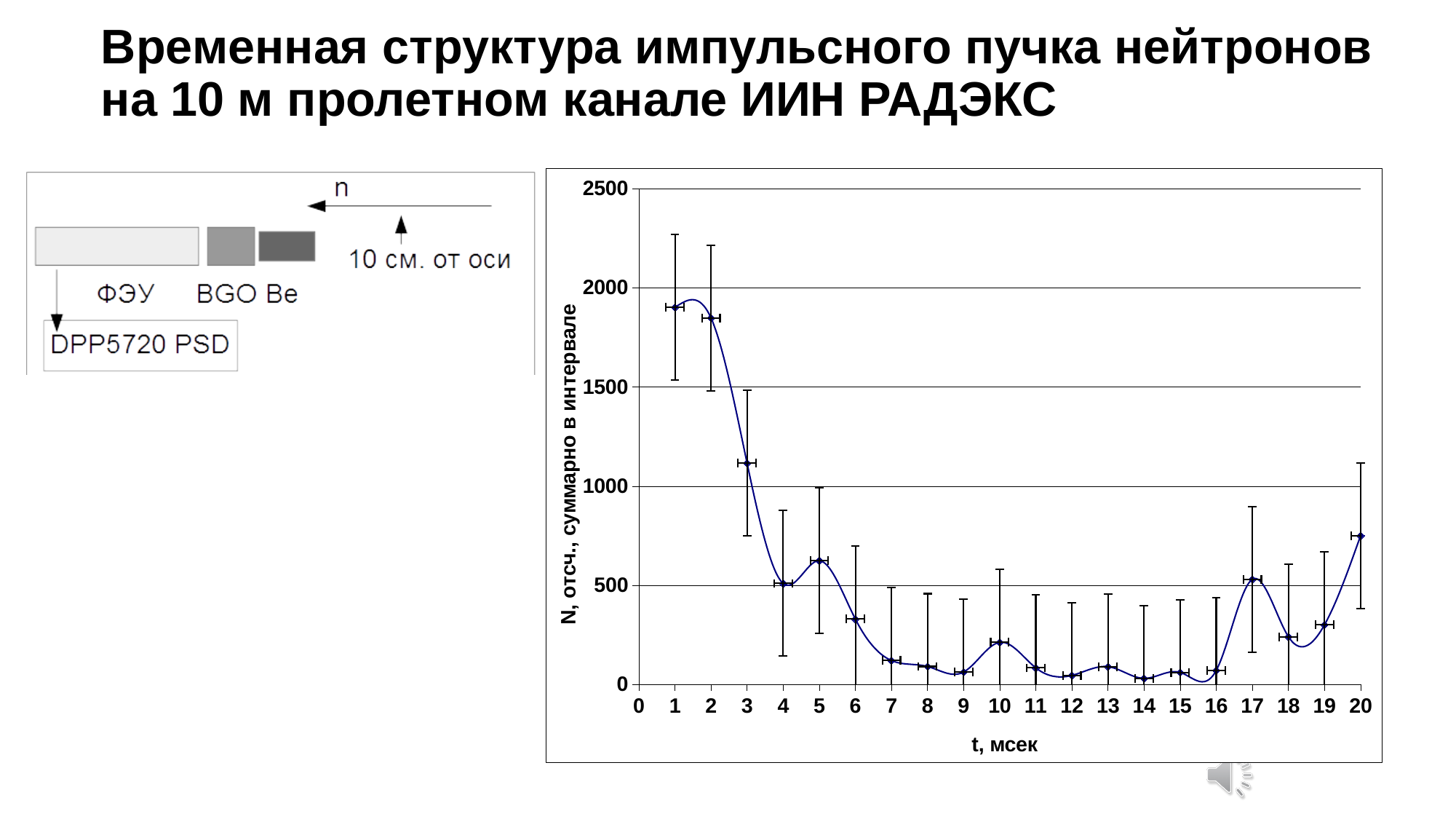
What kind of chart is shown on the slide? line chart How many data points are plotted on the chart? 20 What is the title of the x axis of the chart? t, мсек Is the value at t = 6 greater or less than 500? less Is the value at t = 1 greater or less than 2000? less Which is larger, the value at t = 20 or the value at t = 18? t = 20 Is the value at t = 20 greater or less than 500? greater Which is larger, the value at t = 3 or the value at t = 5? t = 3 Do the values rise or fall from t = 1 to t = 9? fall What is the title of the y axis of the chart? N, отсч., суммарно в интервале